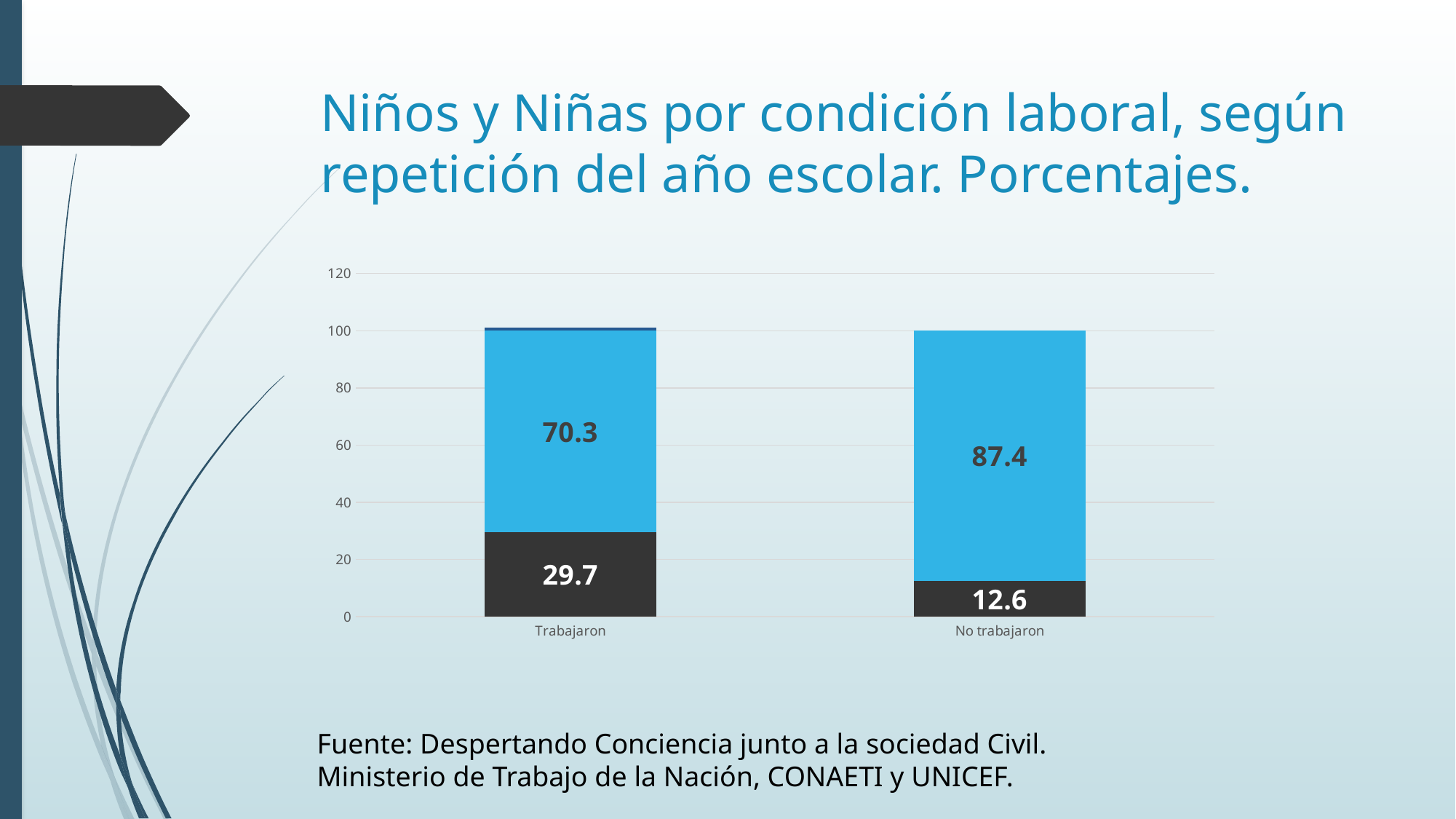
What is the value of the light blue segment for Trabajaron? 70.3 What is the value of the dark segment for Trabajaron? 29.7 What is the difference between the light blue segment values for No trabajaron and Trabajaron? 17.1 How many categories are shown on the x axis of the chart? 2 What kind of chart is shown on the slide? Stacked bar chart What is the value of the light blue segment for No trabajaron? 87.4 What is the title of the slide containing the chart? Niños y Niñas por condición laboral, según repetición del año escolar. Porcentajes. Which category has the larger light blue segment? No trabajaron Which category has the larger dark segment, Trabajaron or No trabajaron? Trabajaron What is the difference between the dark segment values for Trabajaron and No trabajaron? 17.1 What is the value of the dark segment for No trabajaron? 12.6